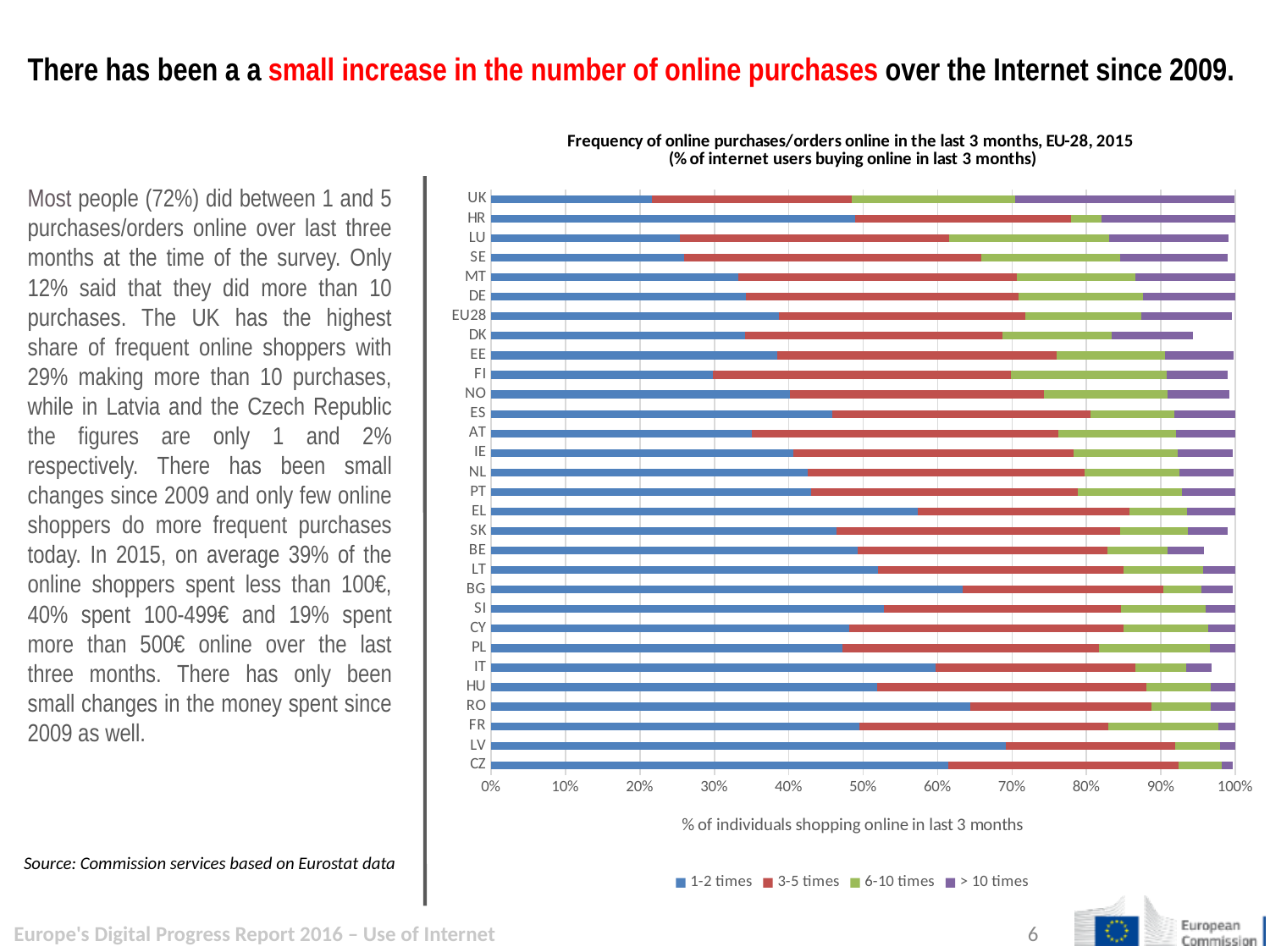
Which country has the longest '1-2 times' segment in the chart? LV Is the '1-2 times' value for LV greater or less than 60%? greater Is the '1-2 times' value for RO greater or less than 60%? greater Which country has the shortest '1-2 times' segment in the chart? UK Which legend entry is shown in purple? > 10 times What kind of chart is shown on the slide? Stacked bar chart Is the '1-2 times' value for EL greater or less than 50%? greater How many series does the chart legend list? 4 What is the title of the chart? Frequency of online purchases/orders online in the last 3 months, EU-28, 2015 (% of internet users buying online in last 3 months) Which has the larger '1-2 times' segment, UK or HR? HR How many countries/regions are listed on the vertical axis of the chart? 30